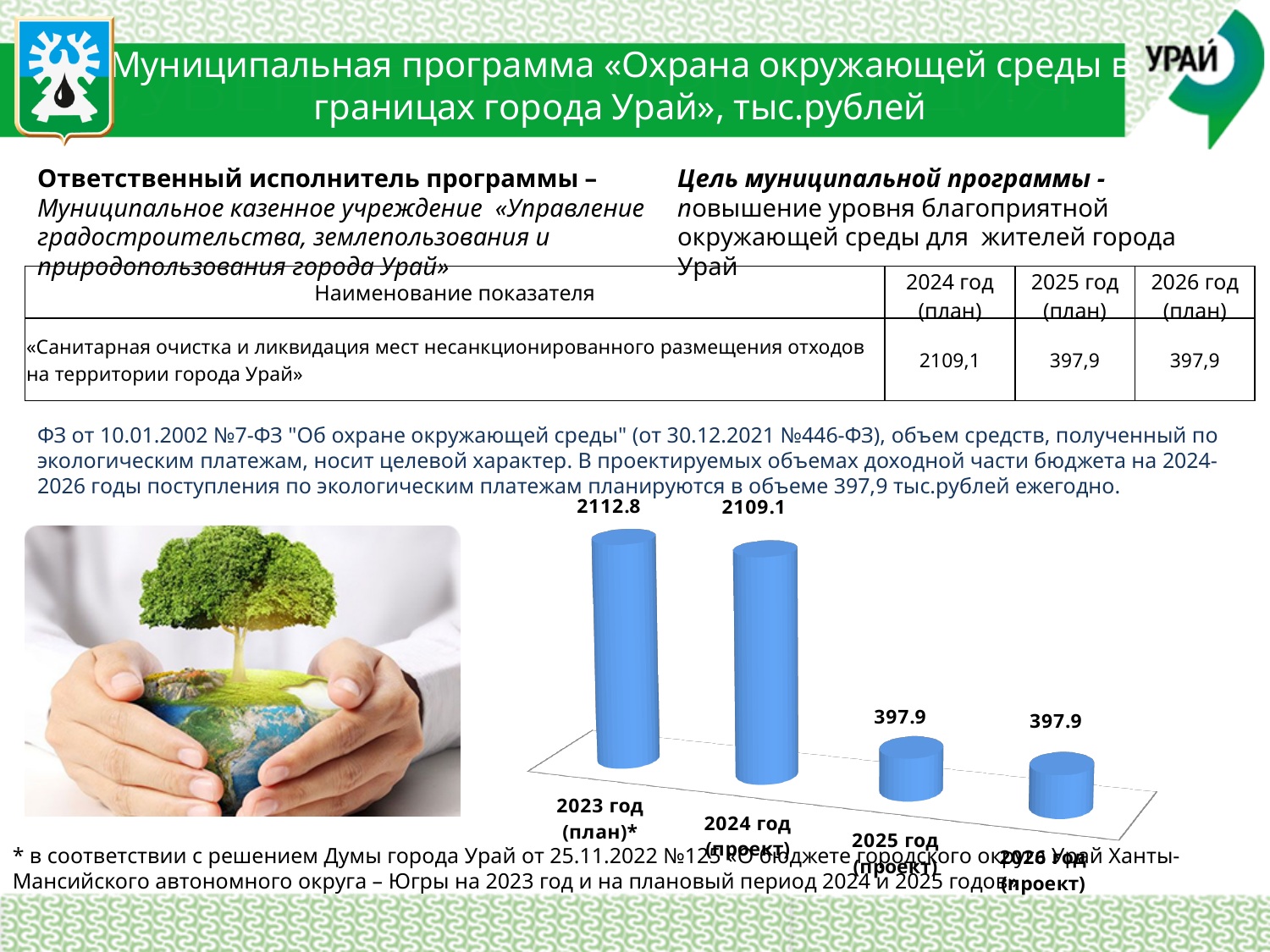
What is the value for 2023 год (план)* in the bar chart? 2112.8 Do the values in the bar chart rise or fall from 2023 год (план)* to 2026 год (проект)? fall Which category has the highest value in the bar chart? 2023 год (план)* What is the value for 2024 год (проект) in the bar chart? 2109.1 What kind of chart is shown on the slide? bar chart What is the value for 2026 год (проект) in the bar chart? 397.9 What is the value for 2025 год (проект) in the bar chart? 397.9 How many categories are shown in the bar chart? 4 Which is larger, the value for 2024 год (проект) or the value for 2026 год (проект)? 2024 год (проект) What colour are the bars in the chart? blue What is the difference between the values for 2023 год (план)* and 2024 год (проект)? 3.7 What is the difference between the values for 2024 год (проект) and 2025 год (проект)? 1711.2